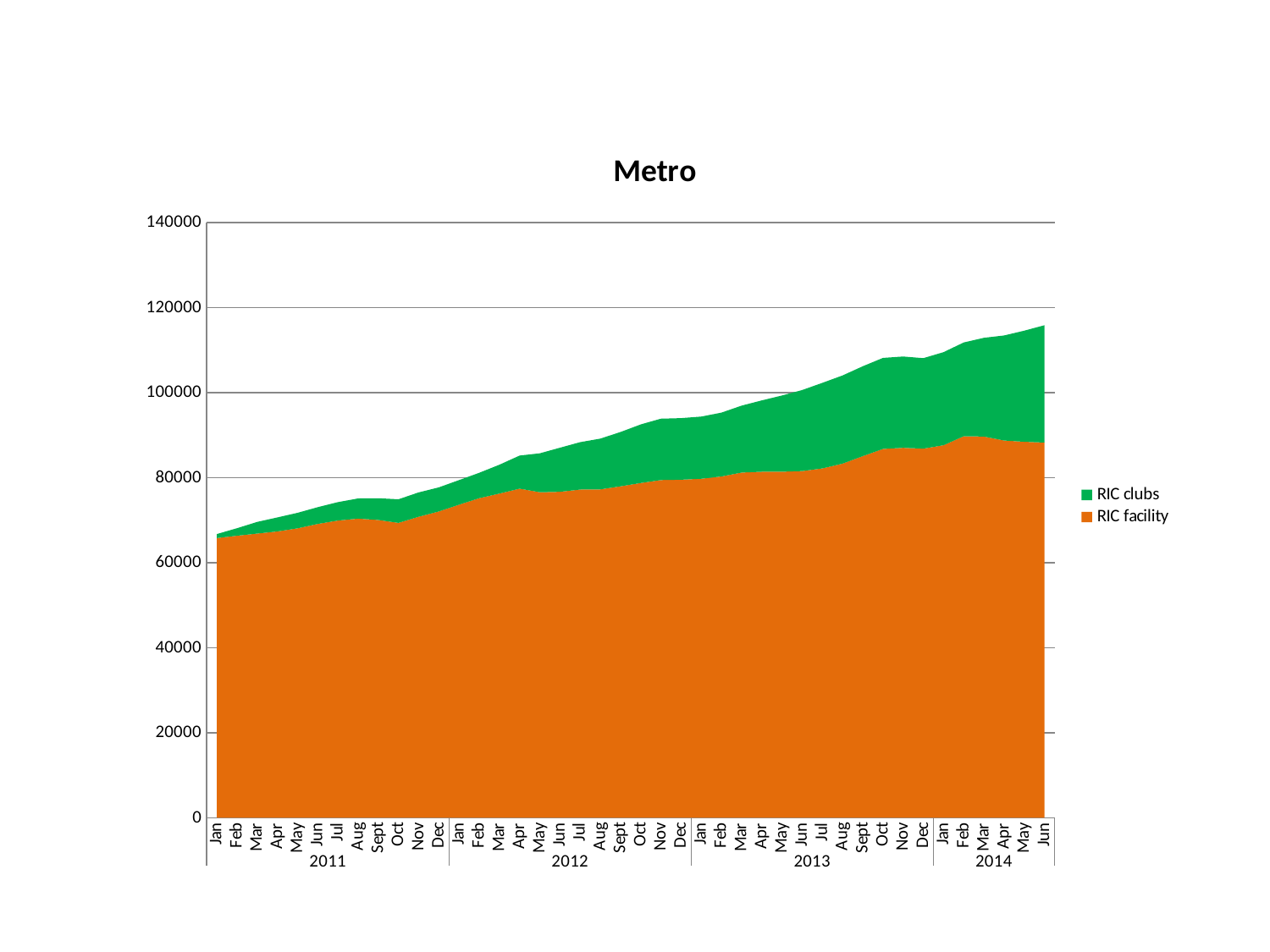
Is the stacked total in Jun 2014 greater or less than 100000? greater Which series has the larger value in Jun 2014, RIC clubs or RIC facility? RIC facility What is the title of the chart? Metro Is the value for RIC facility in Jan 2011 greater or less than 80000? less What kind of chart is shown on the slide? Area chart How many years are labelled on the x axis? 4 In which month and year is the stacked total highest? Jun 2014 Is the stacked total in Jun 2014 greater or less than 120000? less Which series is shown in green? RIC clubs Do the total values rise or fall from Jan 2011 to Jun 2014? Rise How many series does the legend list? 2